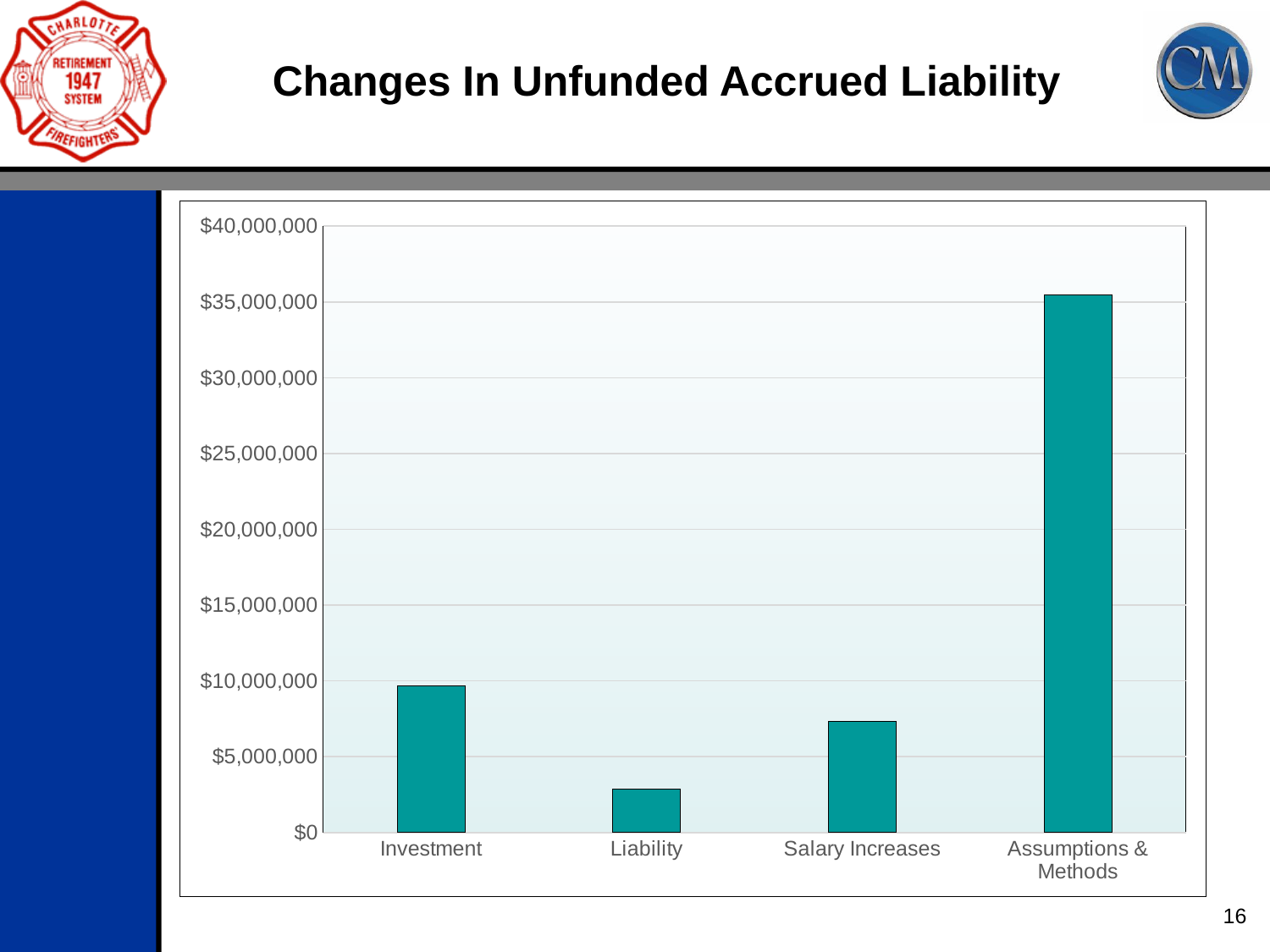
Which is larger, the value for Investment or the value for Salary Increases? Investment How many categories are shown on the x axis of the chart? 4 Is the value for Liability greater or less than $5,000,000? less Which category has the lowest value in the chart? Liability What kind of chart is shown on the slide? bar chart Is the value for Salary Increases greater or less than $5,000,000? greater Is the value for Assumptions & Methods greater or less than $30,000,000? greater Which category has the highest value in the chart? Assumptions & Methods Which is larger, the value for Liability or the value for Salary Increases? Salary Increases What is the title of the slide containing the chart? Changes In Unfunded Accrued Liability